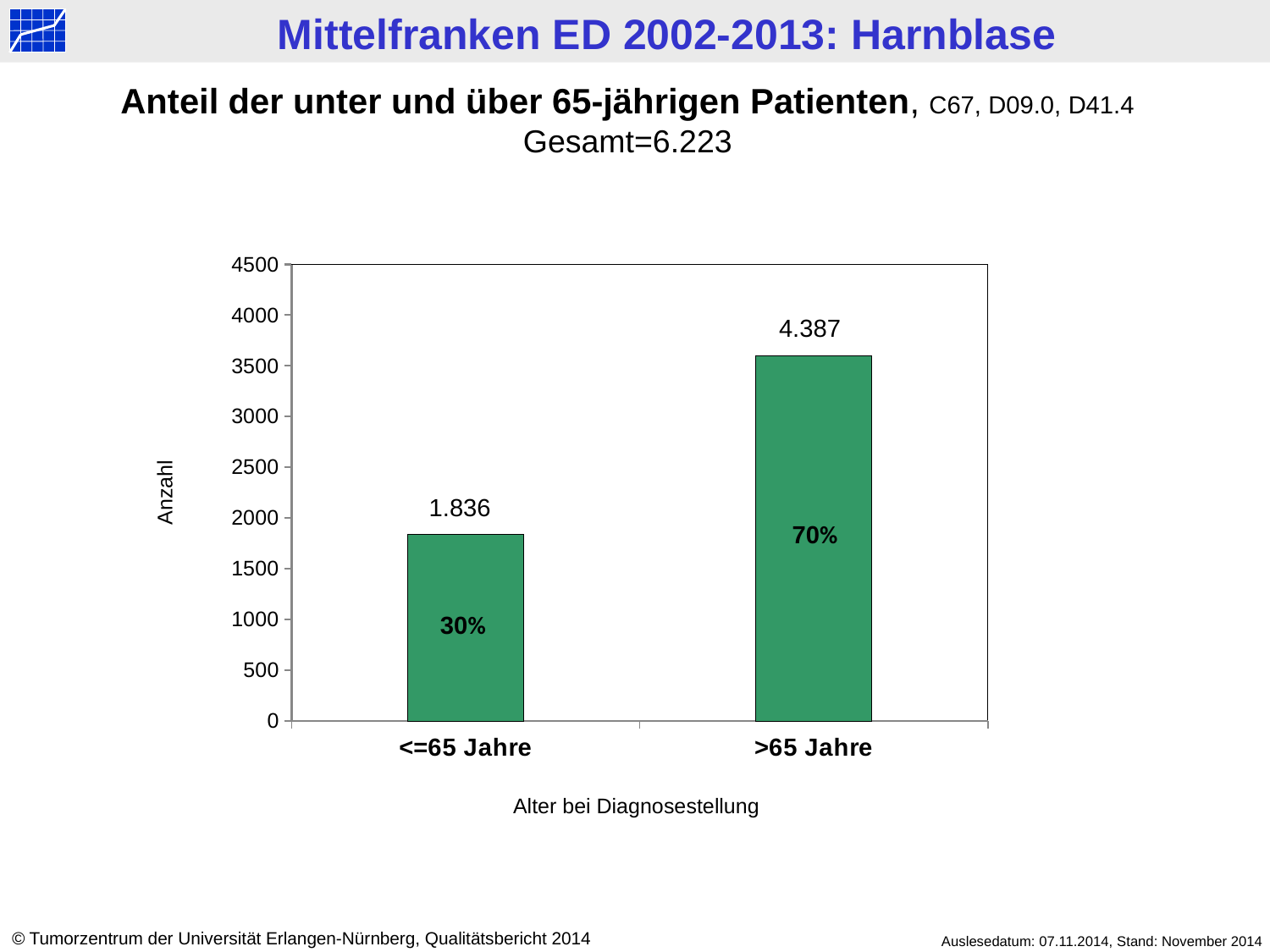
Is the value for "<=65 Jahre" greater or less than 2000? less Which category has the highest value? >65 Jahre Which category has the lowest value? <=65 Jahre Which is larger, the value for "<=65 Jahre" or the value for ">65 Jahre"? >65 Jahre What is the difference between the values for ">65 Jahre" and "<=65 Jahre"? 2.551 What percentage is shown inside the "<=65 Jahre" bar? 30% What is the value for the ">65 Jahre" category? 4.387 What is the value for the "<=65 Jahre" category? 1.836 How many categories are shown on the x axis? 2 What kind of chart is shown on the slide? bar chart What percentage is shown inside the ">65 Jahre" bar? 70% What is the label of the y axis? Anzahl